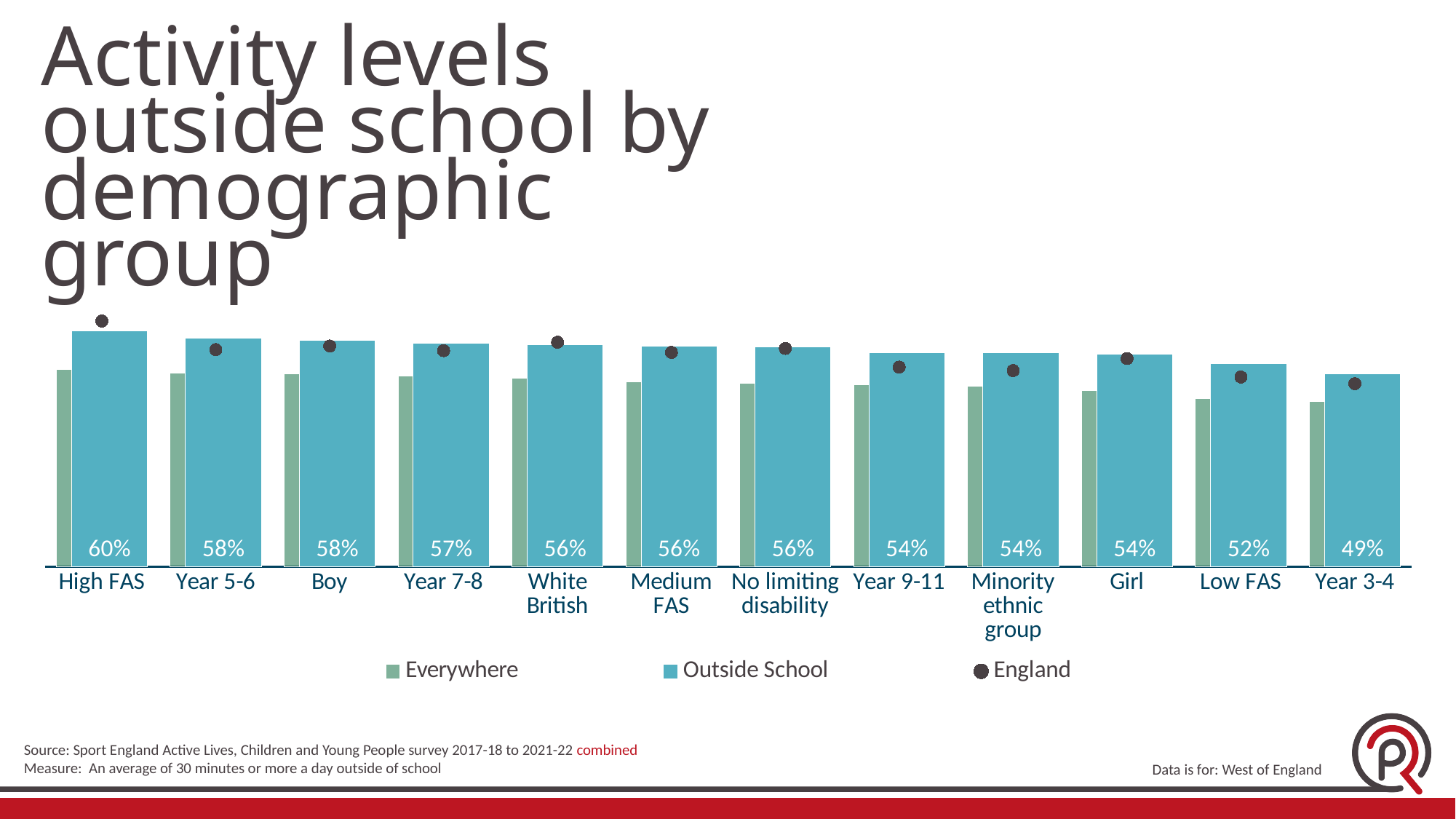
What is the Outside School value for Girl? 54% What is the Outside School value for Low FAS? 52% How many series does the legend list? 3 What is the difference between the Outside School values for High FAS and Year 3-4? 11% What is the Outside School value for Year 3-4? 49% Which demographic group has the highest Outside School value? High FAS How many demographic groups are shown on the x axis? 12 Do the Outside School values rise or fall from left to right along the x axis? Fall What is the Outside School value for High FAS? 60% Which has a larger Outside School value, Boy or Girl? Boy What kind of chart is shown on the slide? Bar chart Which demographic group has the lowest Outside School value? Year 3-4